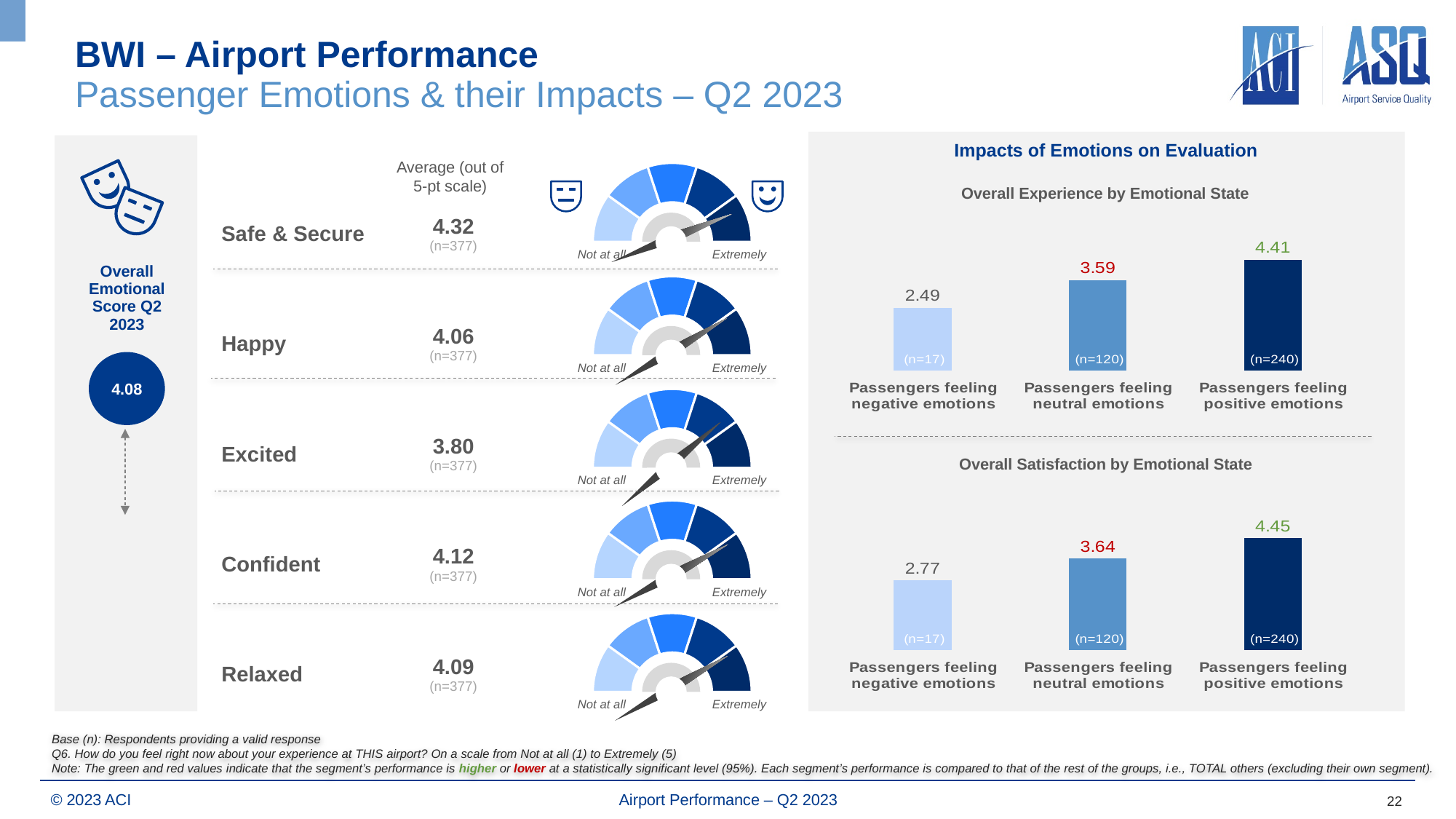
In the 'Overall Experience by Emotional State' chart, what is the sample size (n) shown for passengers feeling positive emotions? n=240 In the 'Overall Satisfaction by Emotional State' chart, which emotional state group has the lowest value? Passengers feeling negative emotions In the 'Overall Experience by Emotional State' chart, which emotional state group has the highest value? Passengers feeling positive emotions In the 'Overall Satisfaction by Emotional State' chart, what is the value for passengers feeling neutral emotions? 3.64 In the 'Overall Experience by Emotional State' chart, what is the value for passengers feeling positive emotions? 4.41 In the 'Overall Satisfaction by Emotional State' chart, what is the value for passengers feeling negative emotions? 2.77 Is the value for passengers feeling neutral emotions larger in the 'Overall Experience by Emotional State' chart or the 'Overall Satisfaction by Emotional State' chart? Overall Satisfaction by Emotional State In the 'Overall Satisfaction by Emotional State' chart, what is the difference between the values for passengers feeling positive emotions and passengers feeling neutral emotions? 0.81 What type of chart is 'Overall Satisfaction by Emotional State'? Bar chart In the 'Overall Experience by Emotional State' chart, what is the difference between the values for passengers feeling positive emotions and passengers feeling negative emotions? 1.92 How many emotional state groups are shown in the 'Overall Experience by Emotional State' chart? 3 In the 'Overall Experience by Emotional State' chart, what is the value for passengers feeling negative emotions? 2.49